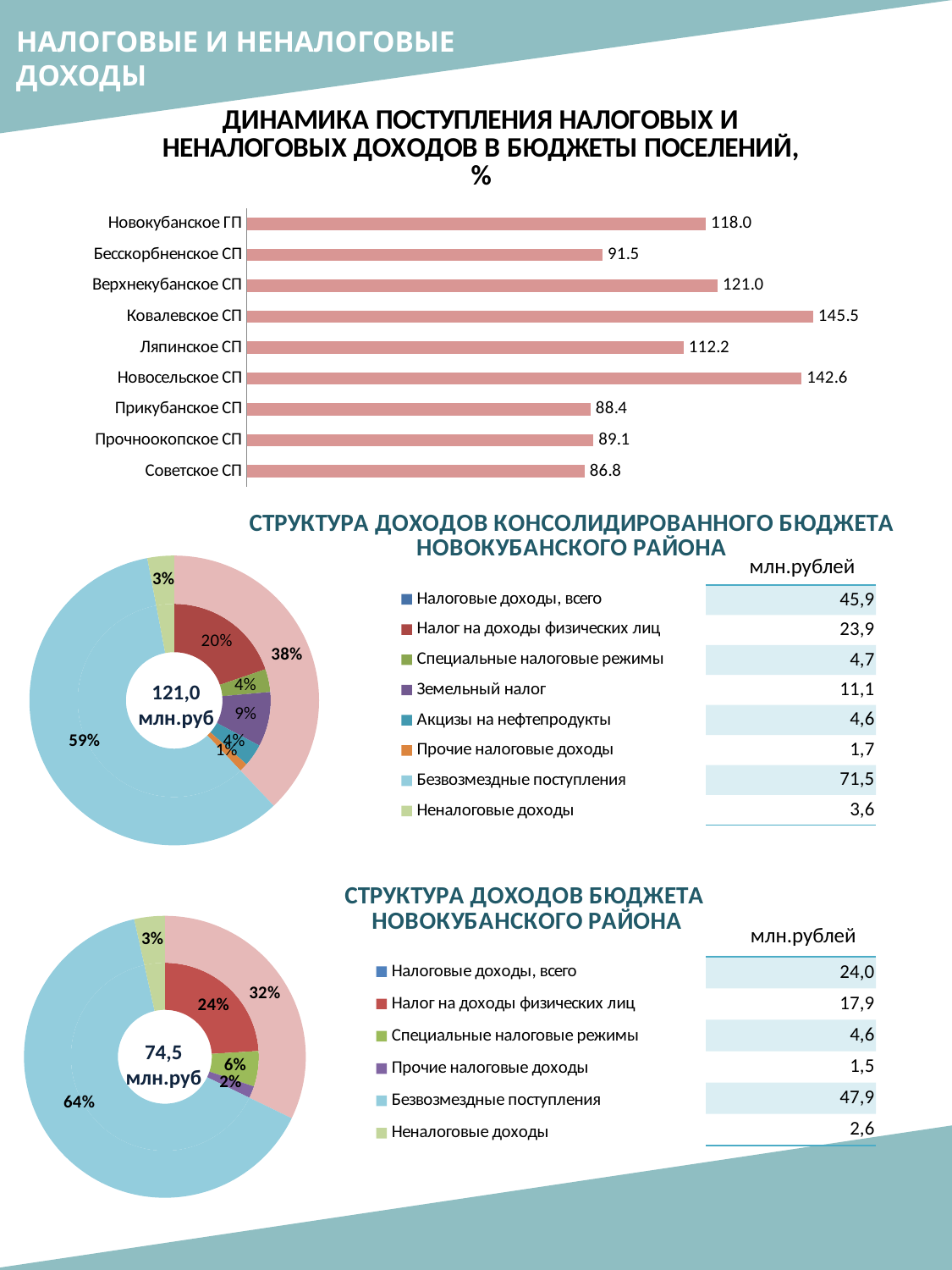
How many entries does the legend of the chart 'СТРУКТУРА ДОХОДОВ КОНСОЛИДИРОВАННОГО БЮДЖЕТА НОВОКУБАНСКОГО РАЙОНА' list? 8 How many settlements are shown on the chart 'ДИНАМИКА ПОСТУПЛЕНИЯ НАЛОГОВЫХ И НЕНАЛОГОВЫХ ДОХОДОВ В БЮДЖЕТЫ ПОСЕЛЕНИЙ, %'? 9 On the chart 'СТРУКТУРА ДОХОДОВ КОНСОЛИДИРОВАННОГО БЮДЖЕТА НОВОКУБАНСКОГО РАЙОНА', what is the value for Безвозмездные поступления in млн.рублей? 71,5 On the chart 'ДИНАМИКА ПОСТУПЛЕНИЯ НАЛОГОВЫХ И НЕНАЛОГОВЫХ ДОХОДОВ В БЮДЖЕТЫ ПОСЕЛЕНИЙ, %', which settlement has the highest value? Ковалевское СП On the chart 'ДИНАМИКА ПОСТУПЛЕНИЯ НАЛОГОВЫХ И НЕНАЛОГОВЫХ ДОХОДОВ В БЮДЖЕТЫ ПОСЕЛЕНИЙ, %', which is larger: the value for Новокубанское ГП or for Верхнекубанское СП? Верхнекубанское СП What kind of chart is 'ДИНАМИКА ПОСТУПЛЕНИЯ НАЛОГОВЫХ И НЕНАЛОГОВЫХ ДОХОДОВ В БЮДЖЕТЫ ПОСЕЛЕНИЙ, %'? Bar chart On the chart 'ДИНАМИКА ПОСТУПЛЕНИЯ НАЛОГОВЫХ И НЕНАЛОГОВЫХ ДОХОДОВ В БЮДЖЕТЫ ПОСЕЛЕНИЙ, %', what is the difference between the values for Ковалевское СП and Советское СП? 58.7 On the chart 'ДИНАМИКА ПОСТУПЛЕНИЯ НАЛОГОВЫХ И НЕНАЛОГОВЫХ ДОХОДОВ В БЮДЖЕТЫ ПОСЕЛЕНИЙ, %', what is the value for Ковалевское СП? 145.5 What total in млн.руб is shown in the centre of the chart 'СТРУКТУРА ДОХОДОВ БЮДЖЕТА НОВОКУБАНСКОГО РАЙОНА'? 74,5 млн.руб On the chart 'СТРУКТУРА ДОХОДОВ БЮДЖЕТА НОВОКУБАНСКОГО РАЙОНА', what is the value for Налог на доходы физических лиц in млн.рублей? 17,9 On the chart 'ДИНАМИКА ПОСТУПЛЕНИЯ НАЛОГОВЫХ И НЕНАЛОГОВЫХ ДОХОДОВ В БЮДЖЕТЫ ПОСЕЛЕНИЙ, %', which settlement has the lowest value? Советское СП On the chart 'СТРУКТУРА ДОХОДОВ КОНСОЛИДИРОВАННОГО БЮДЖЕТА НОВОКУБАНСКОГО РАЙОНА', what share of the total do Безвозмездные поступления make up? 59%